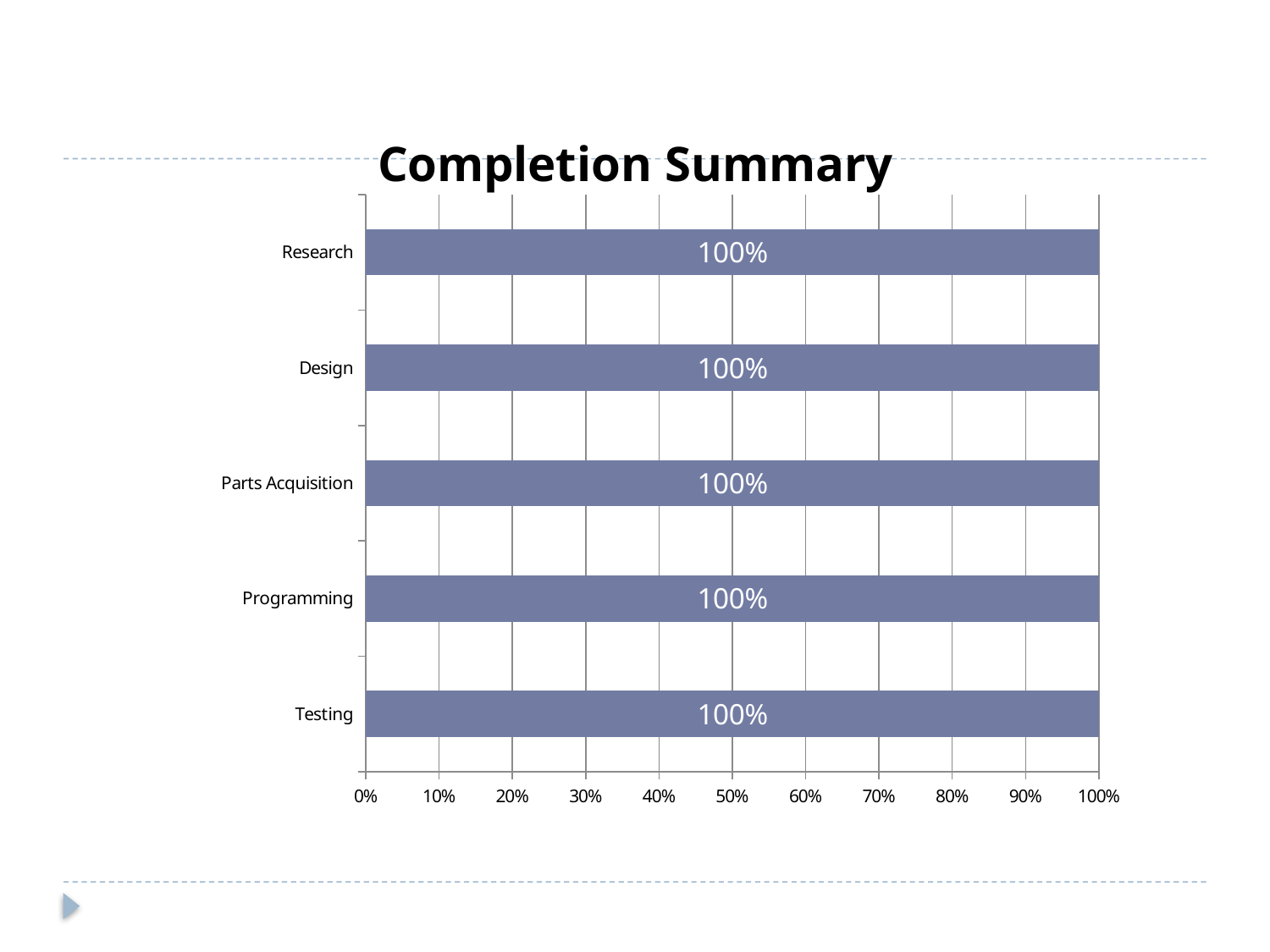
What is the completion value for Testing? 100% What is the completion value for Research? 100% What is the completion value for Programming? 100% Is the value for Programming greater or less than 50%? greater What is the completion value for Parts Acquisition? 100% What is the difference between the values for Research and Testing? 0% How many categories are shown in the chart? 5 What kind of chart is shown on the slide? bar chart What is the completion value for Design? 100% What is the title of the chart? Completion Summary What is the highest value shown on the horizontal axis? 100%